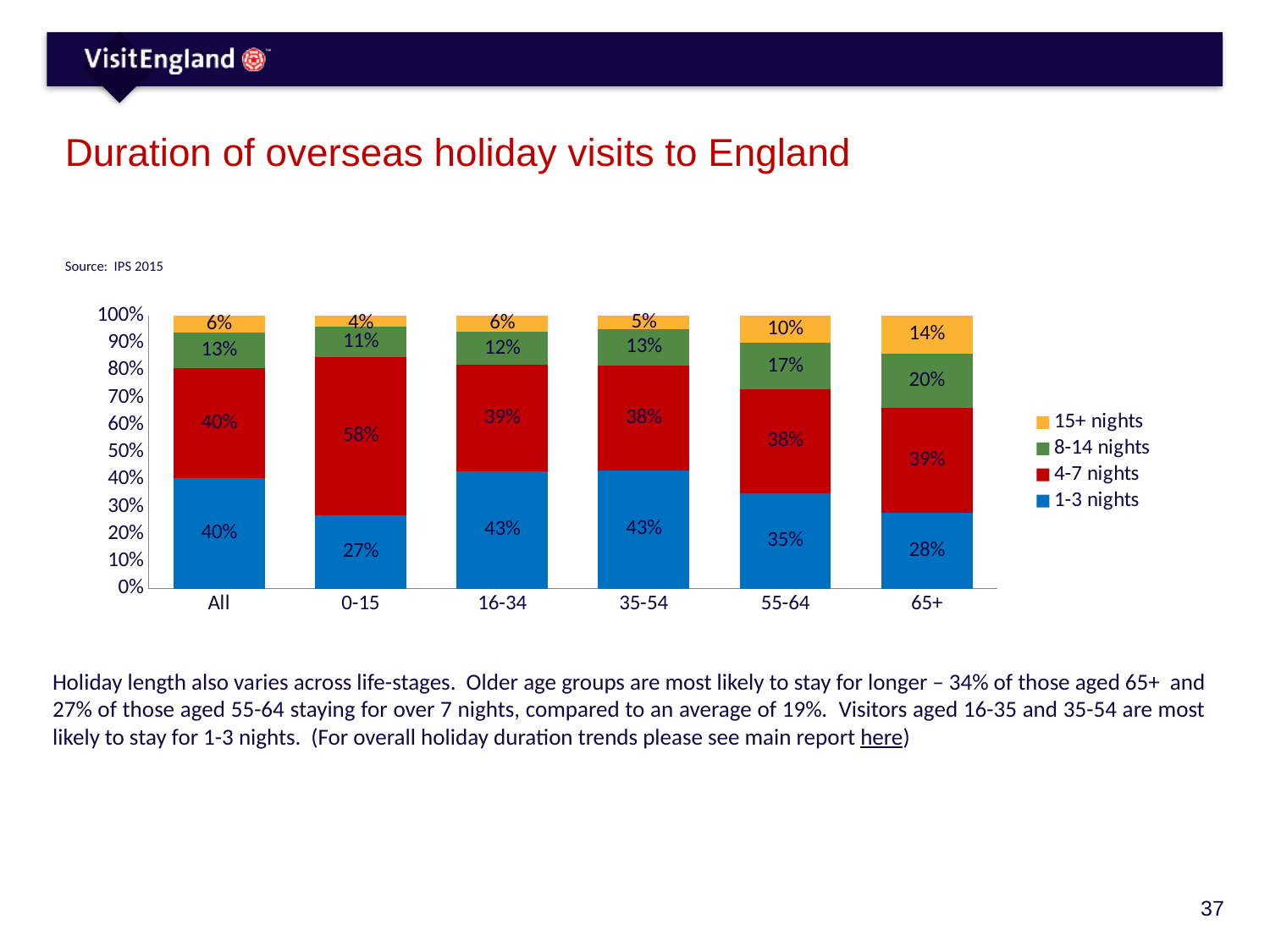
Which colour represents the 1-3 nights series in the legend? Blue Which is larger: the 8-14 nights share for 55-64 or for 65+? 65+ How many series does the legend list? 4 Which age group has the lowest share of visits lasting 1-3 nights? 0-15 What is the value for 1-3 nights in the 55-64 age group? 35% Which age group has the highest share of visits lasting 15+ nights? 65+ How many age categories are shown on the x axis? 6 What share of visits by the 65+ age group last 15+ nights? 14% How many percentage points higher is the 4-7 nights share for the 0-15 group than for 'All'? 18 percentage points What percentage of visits in the 'All' category last 8-14 nights? 13% What type of chart is shown on the slide? Stacked bar chart What percentage of overseas holiday visits by the 0-15 age group last 4-7 nights? 58%